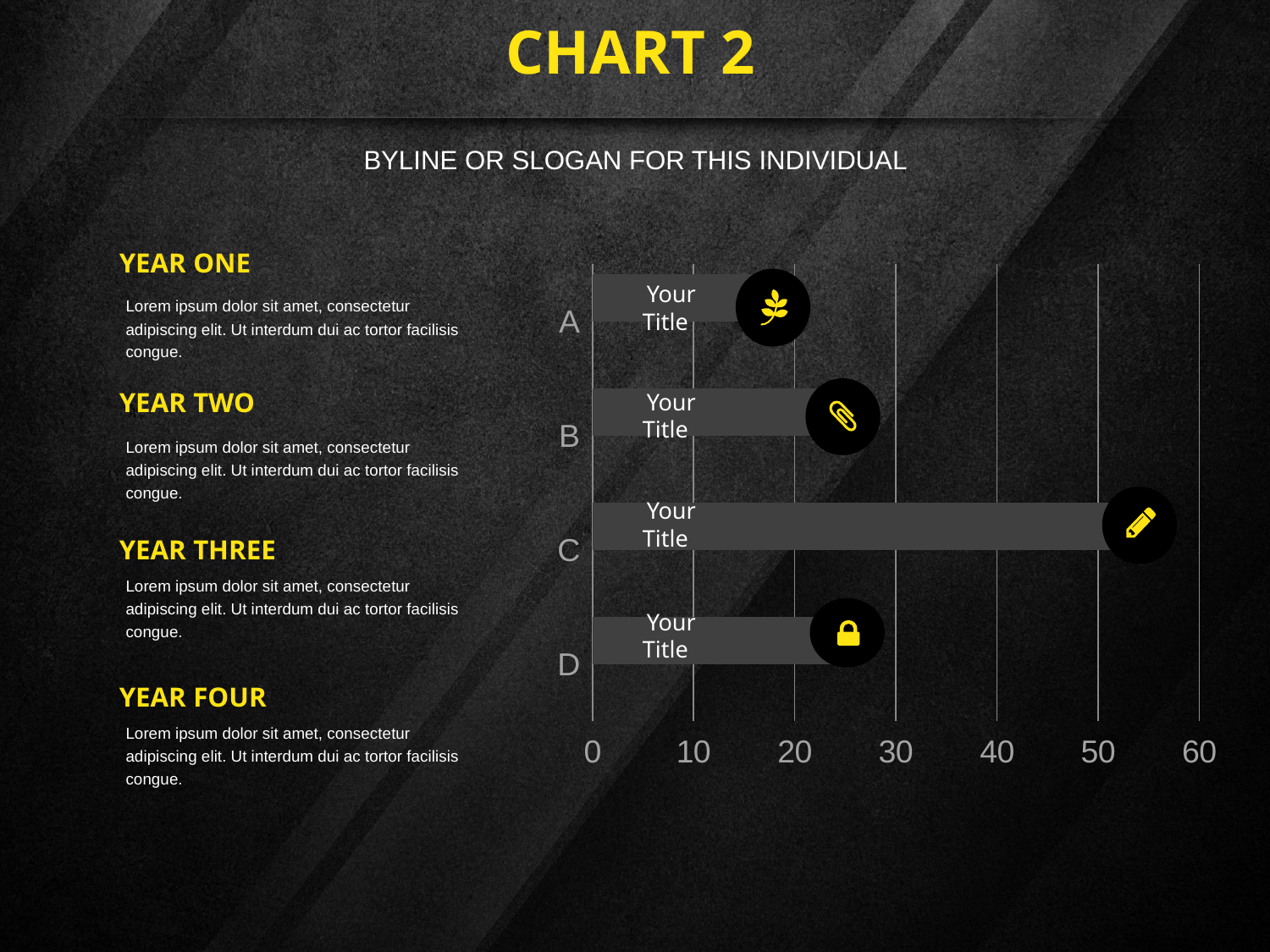
Is the value for D greater or less than 30? less Which category has the lowest value? A What kind of chart is shown on the slide? bar chart Is the value for A greater or less than 20? less Is the value for C greater or less than 40? greater What is the highest value shown on the chart's horizontal axis? 60 Which has the larger value, A or D? D Which has the larger value, C or B? C Which category has the highest value? C How many categories are plotted in the chart? 4 What is the title of the slide containing the chart? CHART 2